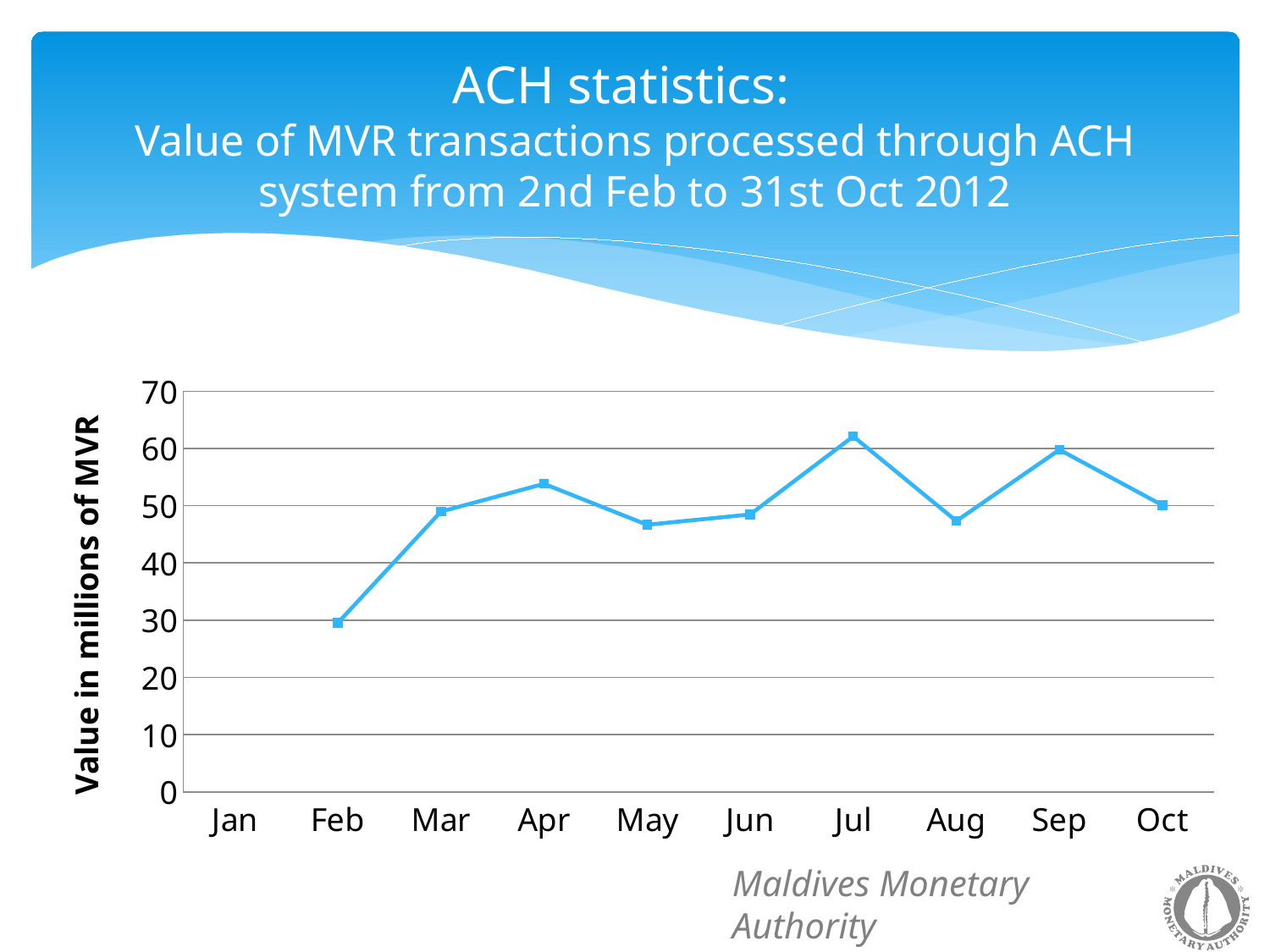
Which month has the highest value of MVR transactions processed through ACH? Jul Which month has the larger value, Jul or Aug? Jul Which month has the lowest value of MVR transactions processed through ACH? Feb Is the value for Apr greater or less than 50? greater Is the value for May greater or less than 50? less Does the value rise or fall from Feb to Apr? rise What kind of chart is shown on the slide? line chart Is the value for Feb greater or less than 40? less Which month has the larger value, Apr or May? Apr What is the title of the vertical axis? Value in millions of MVR How many months have a plotted data point on the chart? 9